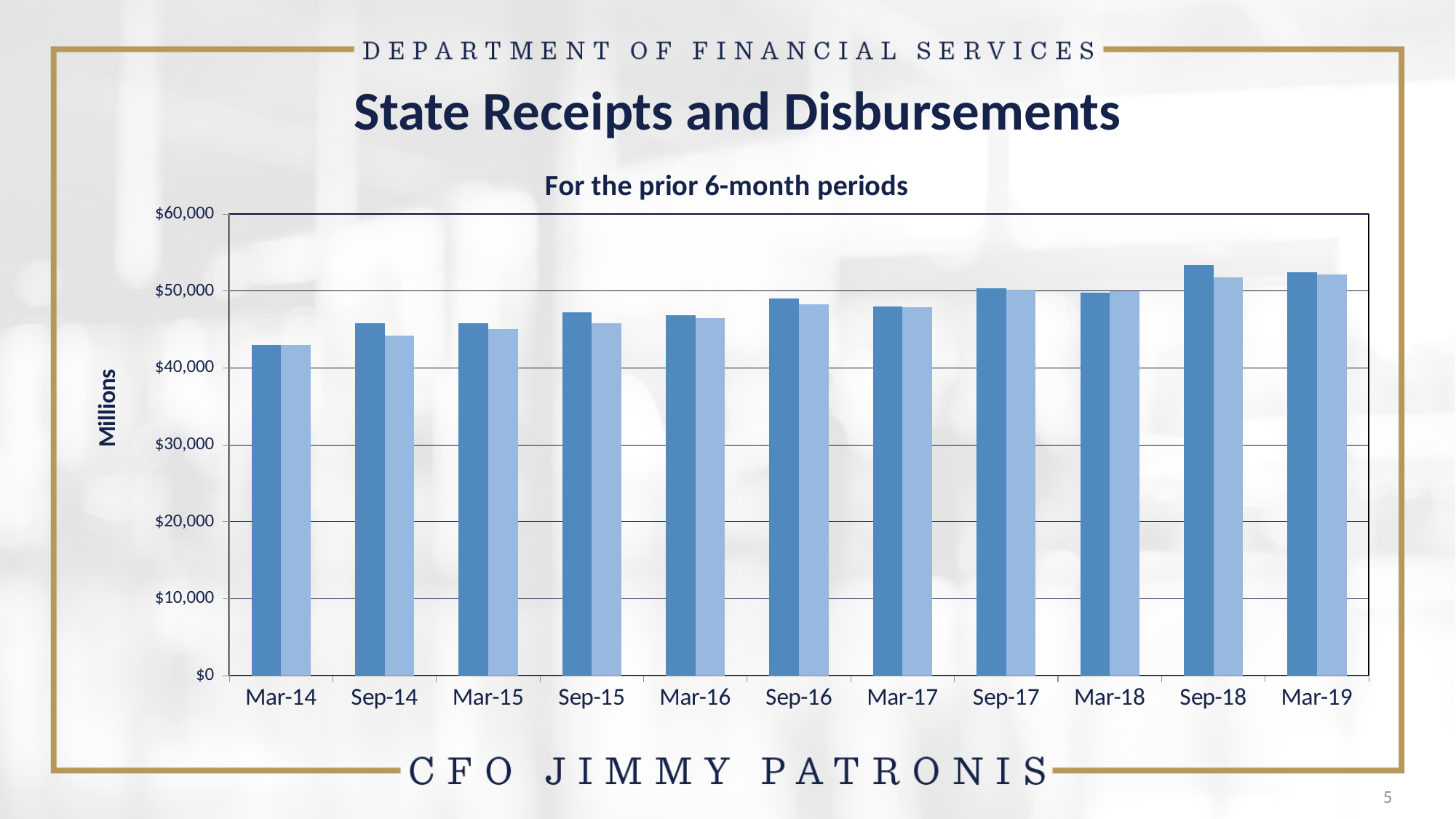
Which is larger, the darker bar for Sep-18 or the darker bar for Mar-14? Sep-18 Which period has the shortest bars in the chart? Mar-14 Do the bar values generally rise or fall from Mar-14 to Mar-19? rise Is the value of the darker bar for Sep-18 greater or less than $50,000? greater Which period has the tallest bar in the chart? Sep-18 How many periods are shown on the x axis of the chart? 11 Is the value of the darker bar for Mar-14 greater or less than $40,000? greater What kind of chart is shown on the slide? bar chart Is the value of the darker bar for Mar-17 greater or less than $50,000? less What is the title shown directly above the chart? For the prior 6-month periods What is the label on the vertical axis of the chart? Millions